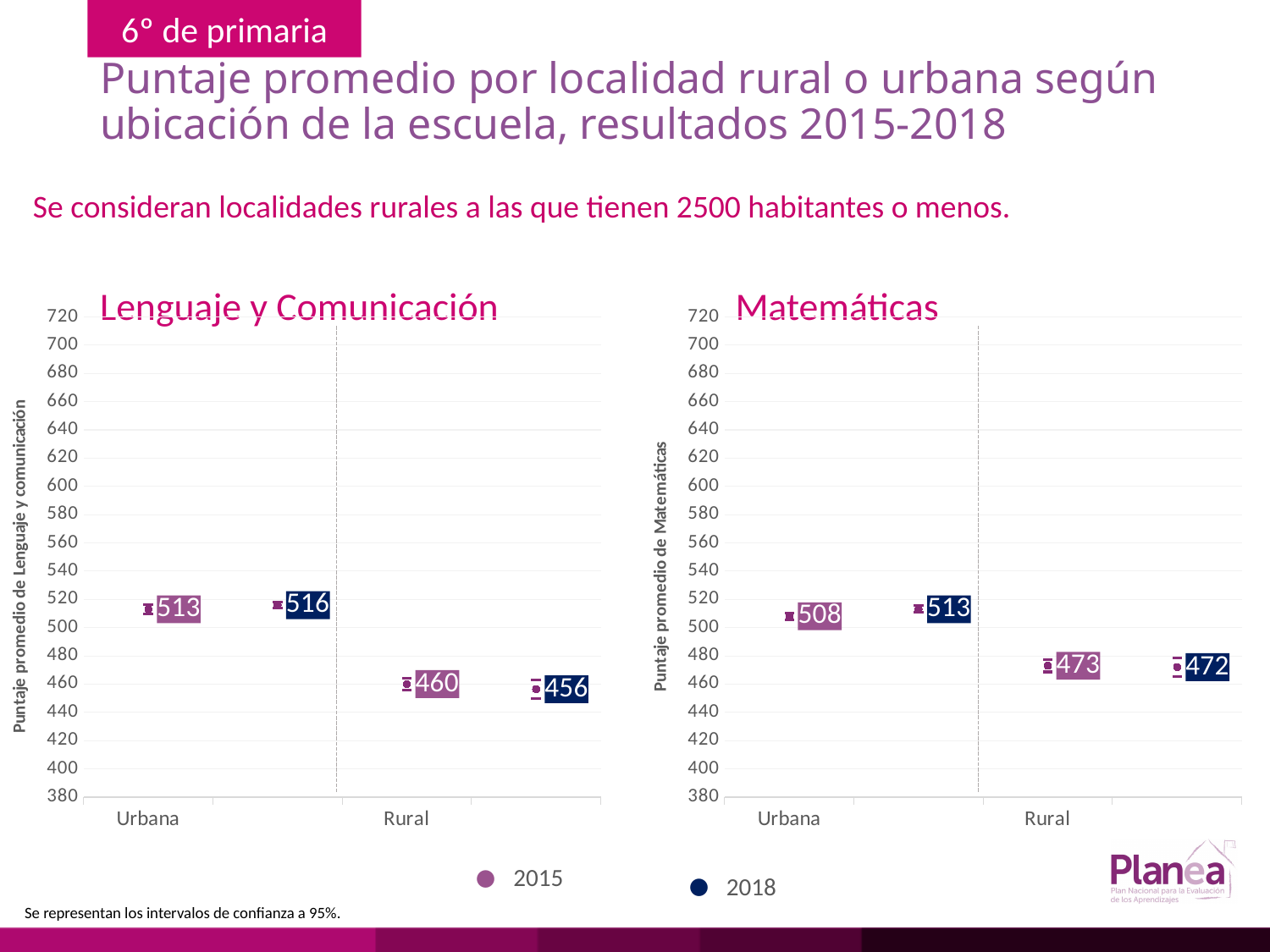
In the Matemáticas chart, what is the difference between the 2015 Urbana value and the 2015 Rural value? 35 In the Matemáticas chart, which is larger for Urbana: the 2015 value or the 2018 value? 2018 In the Matemáticas chart, what is the 2015 value for Urbana? 508 In the Lenguaje y Comunicación chart, what is the difference between the 2018 Urbana value and the 2018 Rural value? 60 In the Lenguaje y Comunicación chart, which is larger for Rural: the 2015 value or the 2018 value? 2015 In the Matemáticas chart, which point has the lowest value? Rural 2018 (472) In the Lenguaje y Comunicación chart, what is the 2018 value for Rural? 456 In the Matemáticas chart, what is the 2018 value for Rural? 472 How many series does the legend list? 2 What is the title of the chart on the right? Matemáticas In the Lenguaje y Comunicación chart, what is the 2015 value for Urbana? 513 In the Lenguaje y Comunicación chart, which point has the highest value? Urbana 2018 (516)